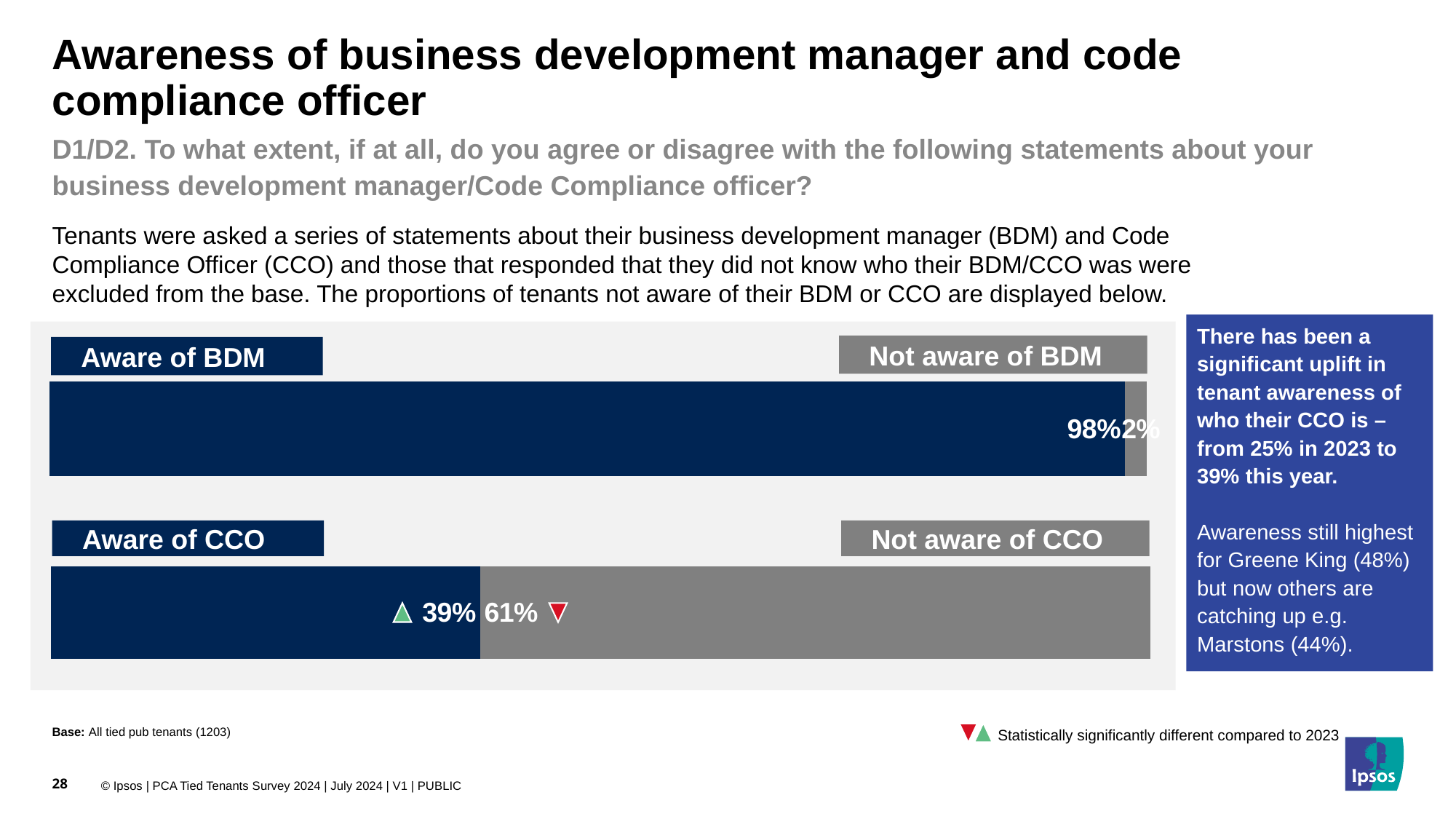
What percentage of tenants are aware of their CCO? 39% What kind of chart is shown on the slide? Stacked bar chart Which bar has the larger 'not aware' segment, BDM or CCO? CCO What is the difference in percentage points between the share not aware of CCO and the share aware of CCO? 22 percentage points What is the difference in percentage points between the share aware of BDM and the share aware of CCO? 59 percentage points What percentage of tenants are not aware of their BDM? 2% What percentage of tenants are not aware of their CCO? 61% Which is higher: awareness of BDM or awareness of CCO? Awareness of BDM How many bars are shown in the chart? 2 What is the total of the two segments in the CCO bar? 100% What percentage of tenants are aware of their BDM? 98% Which colour represents tenants who are not aware of their BDM or CCO? Grey